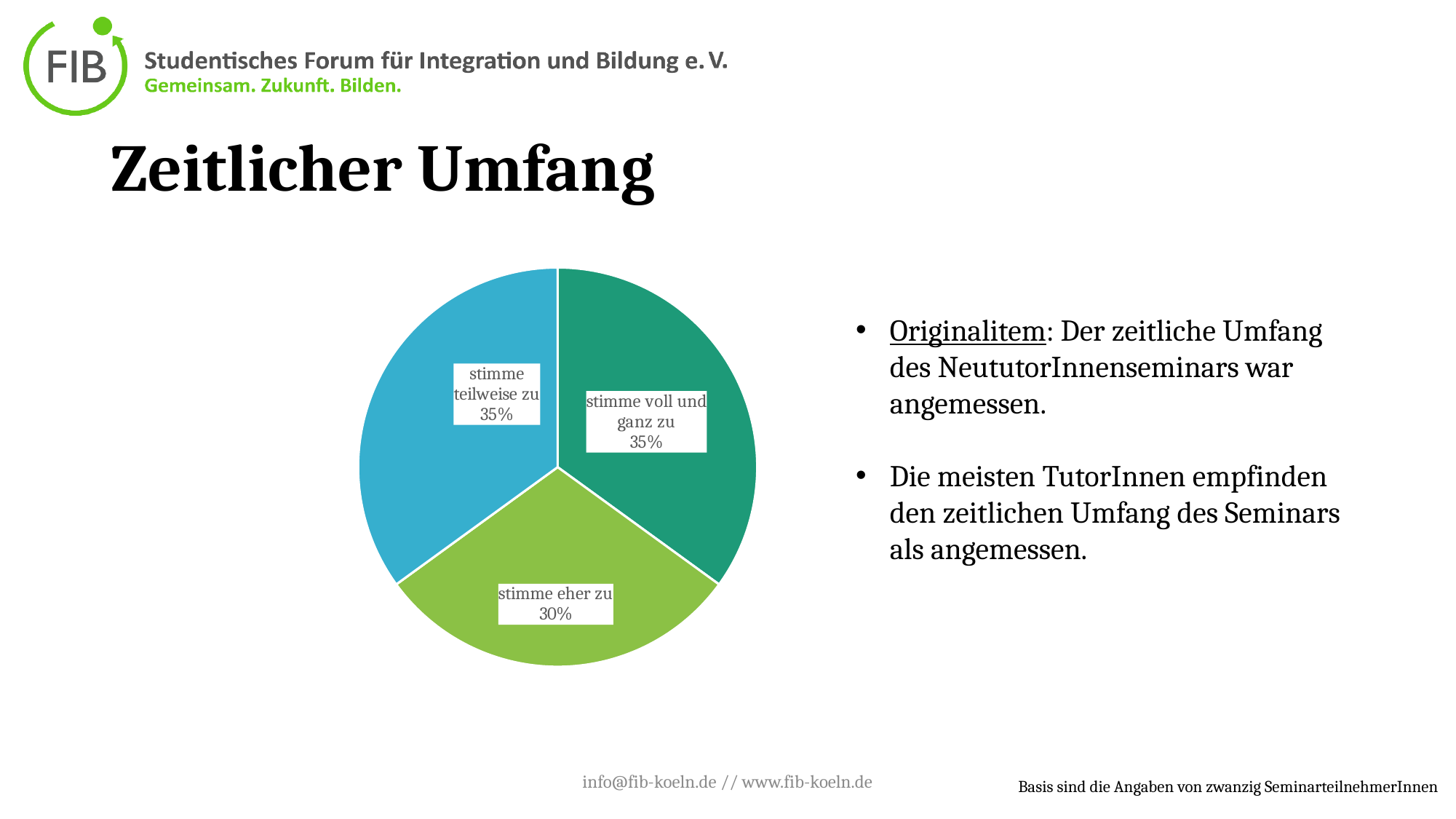
What share of the pie is labelled "stimme teilweise zu"? 35% What kind of chart is shown on the slide? pie chart What is the combined share of "stimme voll und ganz zu" and "stimme eher zu"? 65% Which is larger: the share for "stimme eher zu" or the share for "stimme teilweise zu"? stimme teilweise zu What is the title of the slide containing the pie chart? Zeitlicher Umfang What share of the pie is labelled "stimme voll und ganz zu"? 35% What is the difference between the share for "stimme voll und ganz zu" and the share for "stimme eher zu"? 5% Do the shares for "stimme voll und ganz zu" and "stimme teilweise zu" have the same value? yes What colour is the "stimme eher zu" slice of the pie chart? light green What share of the pie is labelled "stimme eher zu"? 30% How many slices does the pie chart have? 3 Which slice of the pie chart is the smallest? stimme eher zu